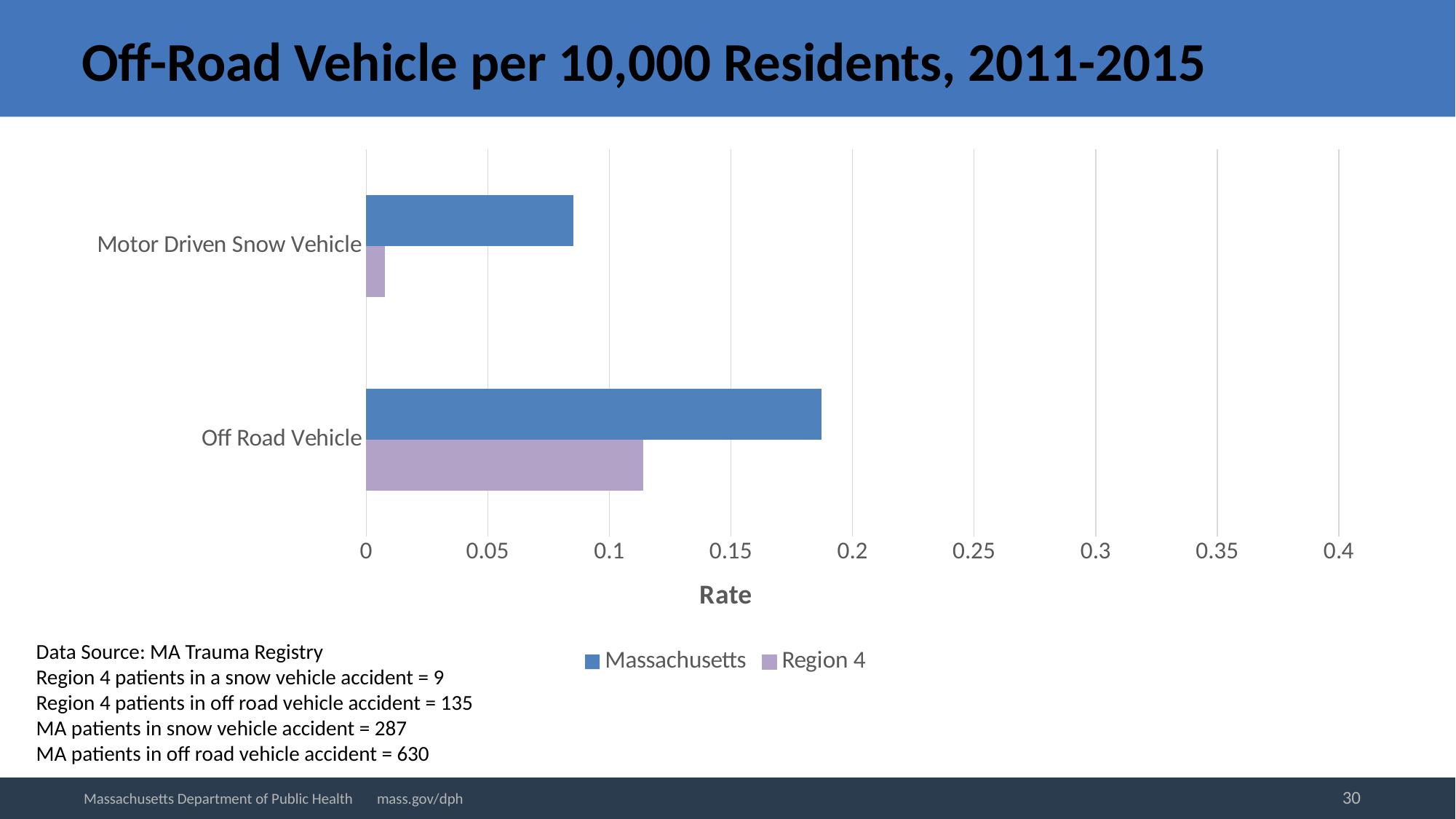
Is the Region 4 rate for Off Road Vehicle greater or less than 0.1? greater Is the Region 4 rate for Motor Driven Snow Vehicle greater or less than 0.05? less How many categories are shown on the chart? 2 Which category has the lowest Region 4 rate? Motor Driven Snow Vehicle For Off Road Vehicle, which series has the larger rate, Massachusetts or Region 4? Massachusetts Is the Massachusetts rate for Motor Driven Snow Vehicle greater or less than 0.1? less Which category has the highest Massachusetts rate? Off Road Vehicle How many series does the legend list? 2 What is the label of the horizontal axis? Rate For Motor Driven Snow Vehicle, which series has the larger rate, Massachusetts or Region 4? Massachusetts What kind of chart is shown on the slide? bar chart